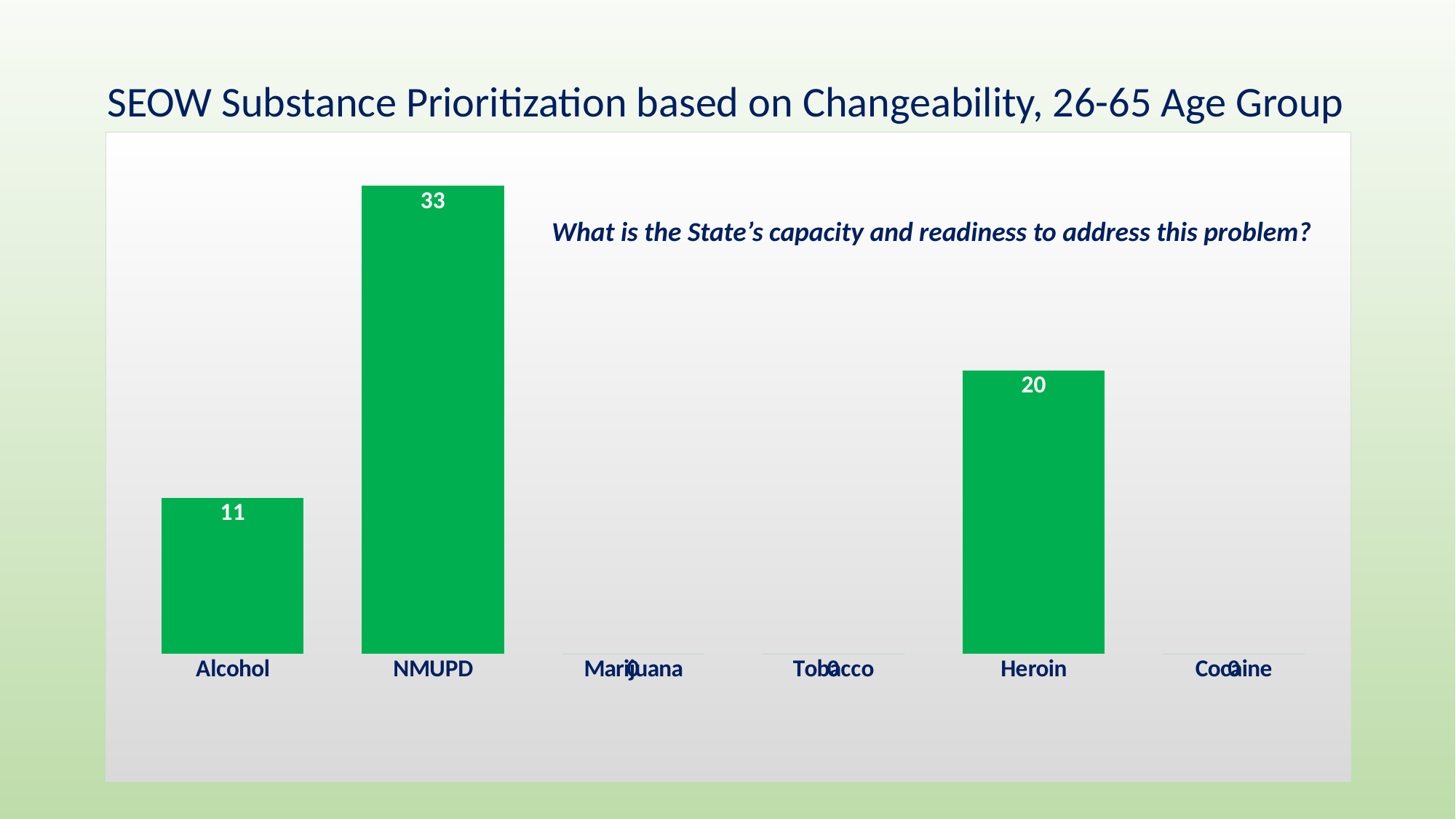
What is the difference between the values for Heroin and Alcohol? 9 What kind of chart is shown on the slide? Bar chart Which has a larger value, Alcohol or Heroin? Heroin Which substance has the highest value? NMUPD What is the difference between the values for NMUPD and Heroin? 13 What is the value for Marijuana? 0 What is the value for NMUPD? 33 What is the value for Heroin? 20 How many substance categories are shown on the x axis? 6 What is the title of the slide? SEOW Substance Prioritization based on Changeability, 26-65 Age Group How many categories have a value of 0? 3 What is the value for Alcohol? 11